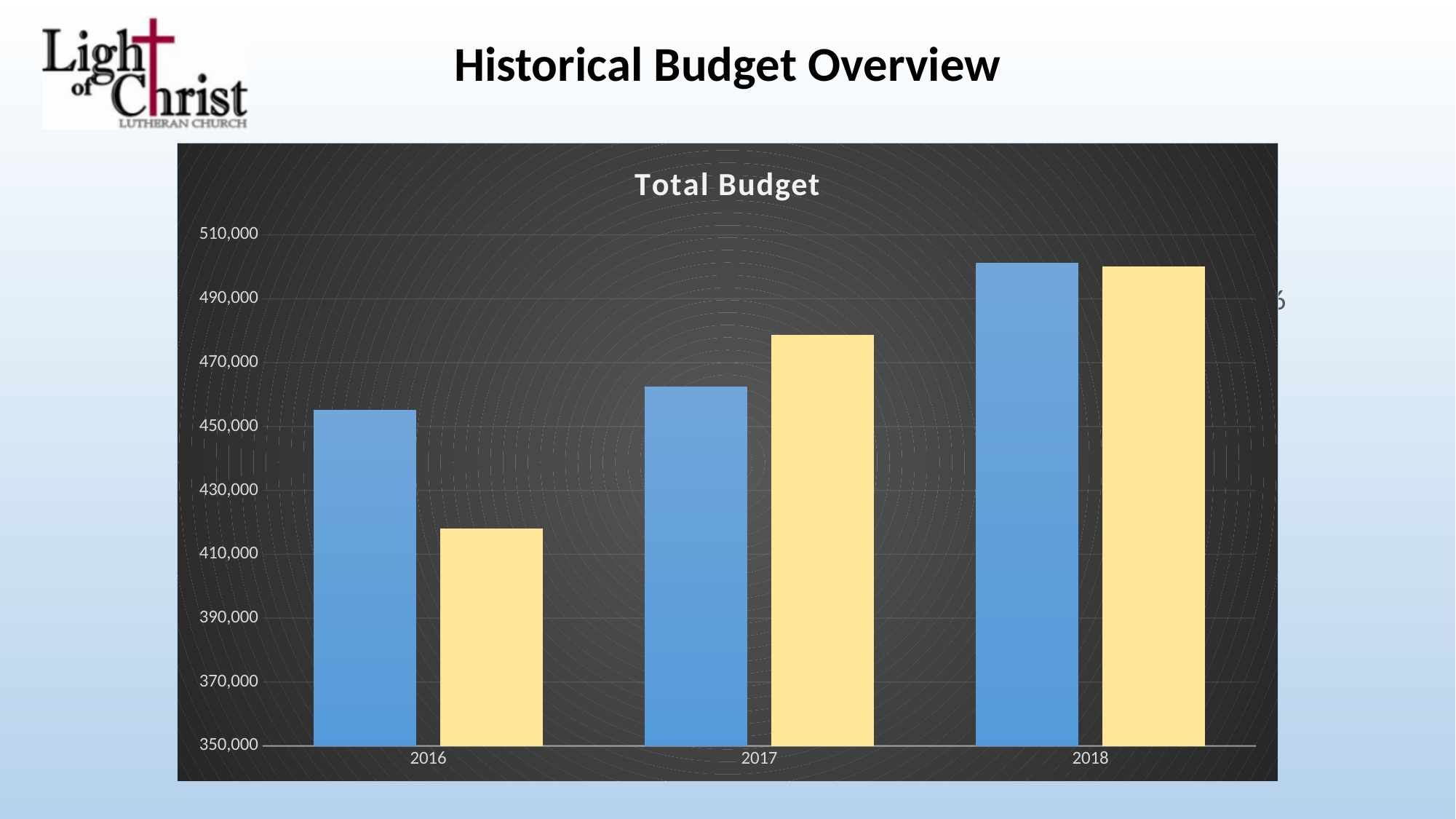
For 2016, which bar is larger, the blue bar or the yellow bar? the blue bar Which year has the lowest yellow bar? 2016 What kind of chart is shown on the slide? bar chart Do the blue bars rise or fall from 2016 to 2018? rise How many bars are shown for each year in the chart? 2 For 2017, which bar is larger, the blue bar or the yellow bar? the yellow bar What is the title of the chart? Total Budget Is the value of the blue bar for 2016 greater or less than 470,000? less Is the value of the blue bar for 2018 greater or less than 490,000? greater Is the value of the yellow bar for 2017 greater or less than 470,000? greater How many years are shown on the x axis of the chart? 3